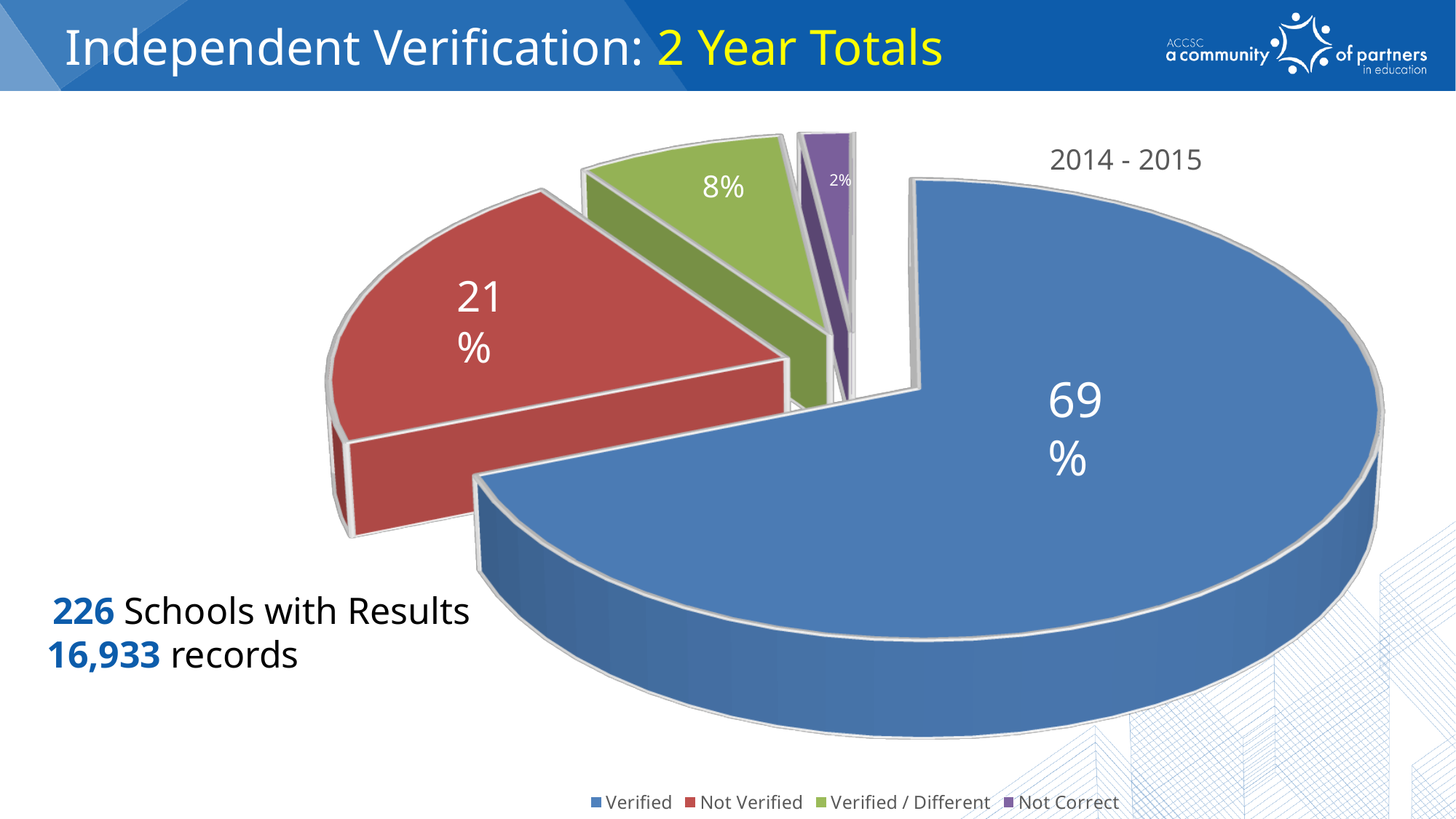
What percentage of the pie is labelled Verified? 69% How many slices does the pie chart have? 4 Which category has the smallest share of the pie? Not Correct What period label appears above the pie chart? 2014 - 2015 How many entries does the legend list? 4 What percentage of the pie is labelled Not Correct? 2% Which slice is larger, Not Verified or Verified / Different? Not Verified Which category has the largest share of the pie? Verified What type of chart is shown on the slide? Pie chart What percentage of the pie is labelled Not Verified? 21% What percentage of the pie is labelled Verified / Different? 8% What is the difference in percentage points between the Verified and Not Verified slices? 48